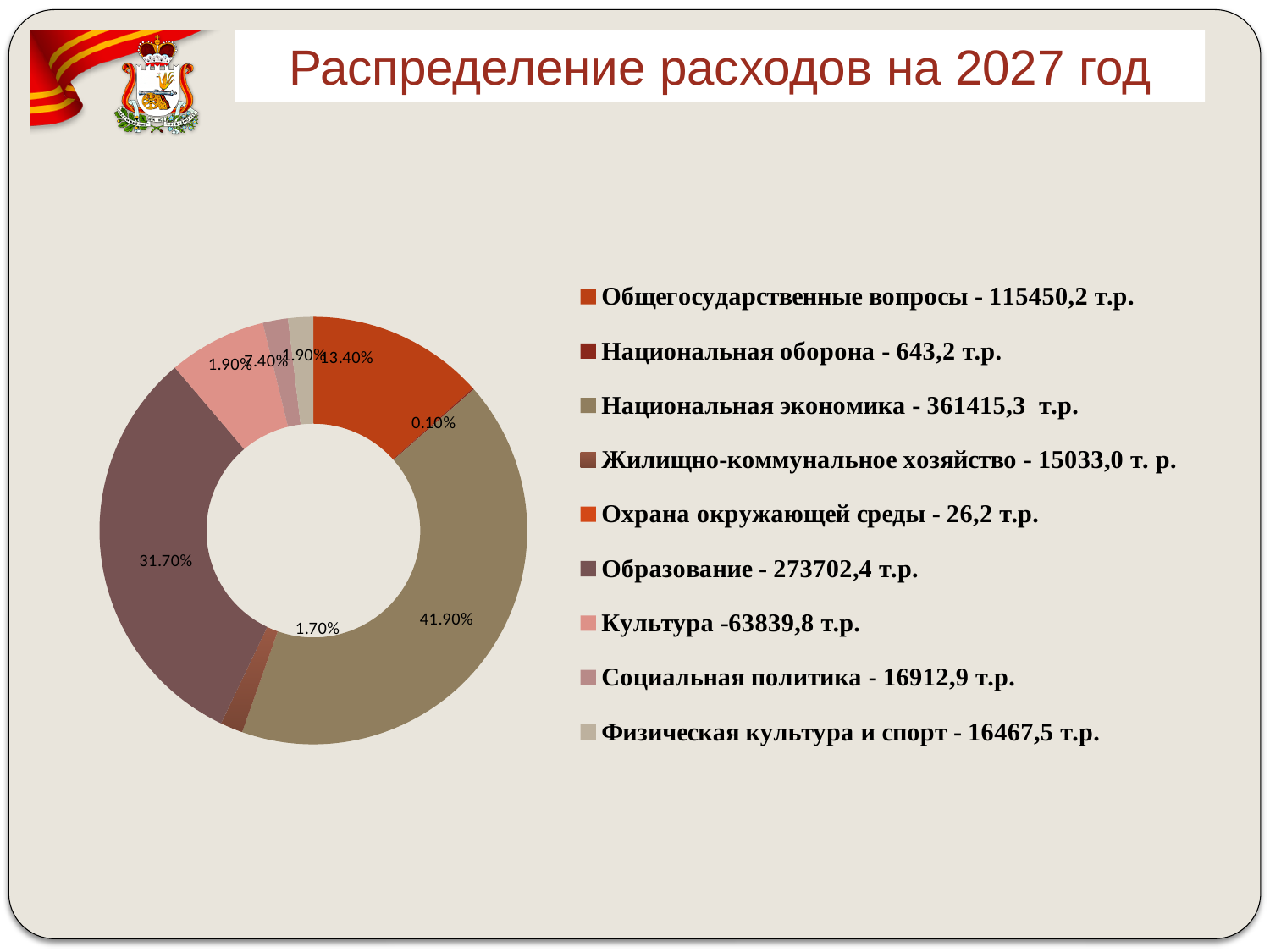
Which category has the smallest amount according to the legend? Охрана окружающей среды - 26,2 т.р. What share of the chart does Национальная экономика take? 41.90% What amount is listed in the legend for Образование? 273702,4 т.р. What is the title of the slide's chart? Распределение расходов на 2027 год What kind of chart is shown on the slide? Doughnut (pie) chart How many categories does the legend list? 9 Which has the larger share: Образование or Общегосударственные вопросы? Образование What is the difference in percentage points between the shares of Национальная экономика and Образование? 10.20% Which category has the largest share of the chart? Национальная экономика What share of the chart does Культура take? 7.40% What share of the chart does Общегосударственные вопросы take? 13.40%